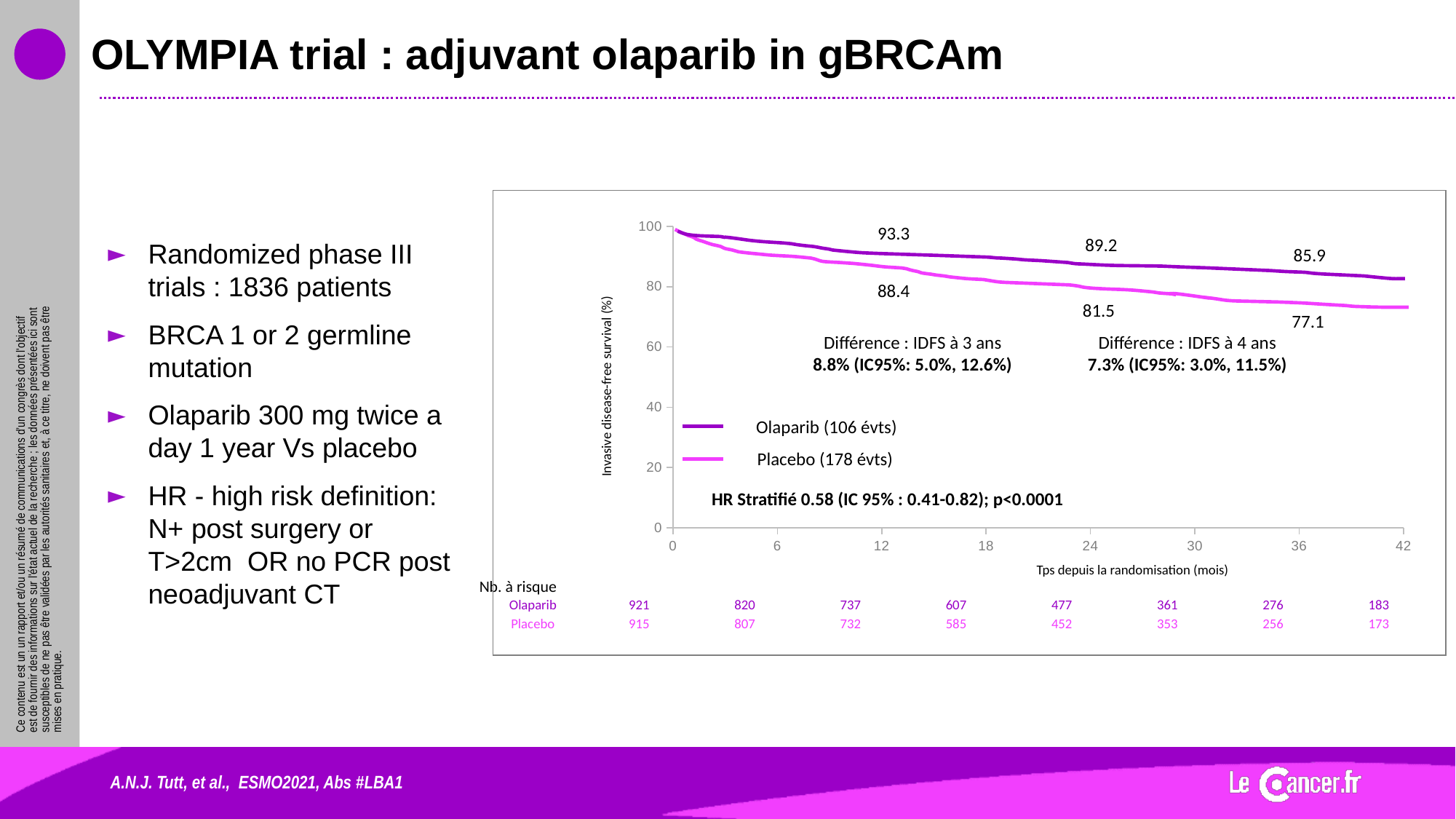
What is the stratified hazard ratio printed on the chart? 0.58 Which curve is higher at the middle labelled time point, Olaparib (89.2) or Placebo (81.5)? Olaparib What is the labelled value for the Placebo curve at the last labelled time point (around 36 months)? 77.1 What is the difference between the labelled Olaparib value (89.2) and the labelled Placebo value (81.5) at the middle labelled time point? 7.7 How many events are reported for the Placebo arm in the legend? 178 évts Do the survival curves rise or fall as time since randomisation increases? fall What kind of chart is shown on the slide? line chart How many series does the chart legend list? 2 What is the labelled invasive disease-free survival value for the Placebo curve at the first labelled time point (around 12 months)? 88.4 What is the number of patients at risk in the Olaparib arm at 24 months? 477 What is the labelled value for the Olaparib curve at the last labelled time point (around 36 months)? 85.9 What is the labelled invasive disease-free survival value for the Olaparib curve at the first labelled time point (around 12 months)? 93.3